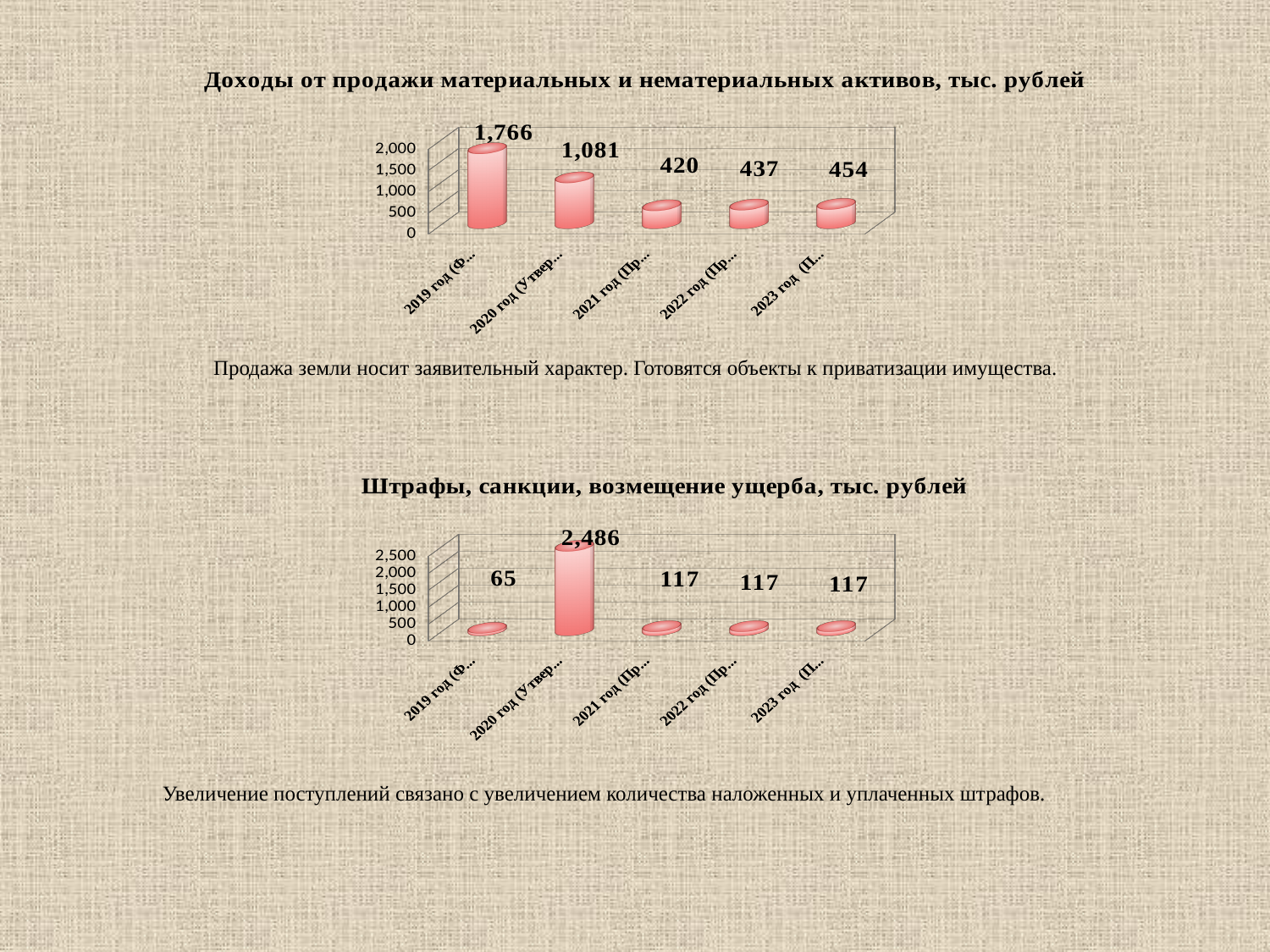
In the top chart (Доходы от продажи материальных и нематериальных активов), what is the difference between the values for 2019 год and 2020 год? 685 In the bottom chart (Штрафы, санкции, возмещение ущерба), what is the difference between the values for 2021 год and 2019 год? 52 In the bottom chart (Штрафы, санкции, возмещение ущерба), which is larger, the value for 2020 год or the value for 2023 год? 2020 год In the top chart (Доходы от продажи материальных и нематериальных активов), what is the value for 2021 год? 420 What kind of chart is the bottom chart (Штрафы, санкции, возмещение ущерба)? Bar chart In the bottom chart (Штрафы, санкции, возмещение ущерба), which year has the lowest value? 2019 год In the top chart (Доходы от продажи материальных и нематериальных активов), how many bars are plotted? 5 In the bottom chart (Штрафы, санкции, возмещение ущерба), what is the value for 2020 год? 2,486 In the top chart (Доходы от продажи материальных и нематериальных активов), what is the value for 2019 год? 1,766 In the top chart (Доходы от продажи материальных и нематериальных активов), which year has the highest value? 2019 год In the top chart (Доходы от продажи материальных и нематериальных активов), which year has the lowest value? 2021 год In the bottom chart (Штрафы, санкции, возмещение ущерба), what is the value for 2019 год? 65